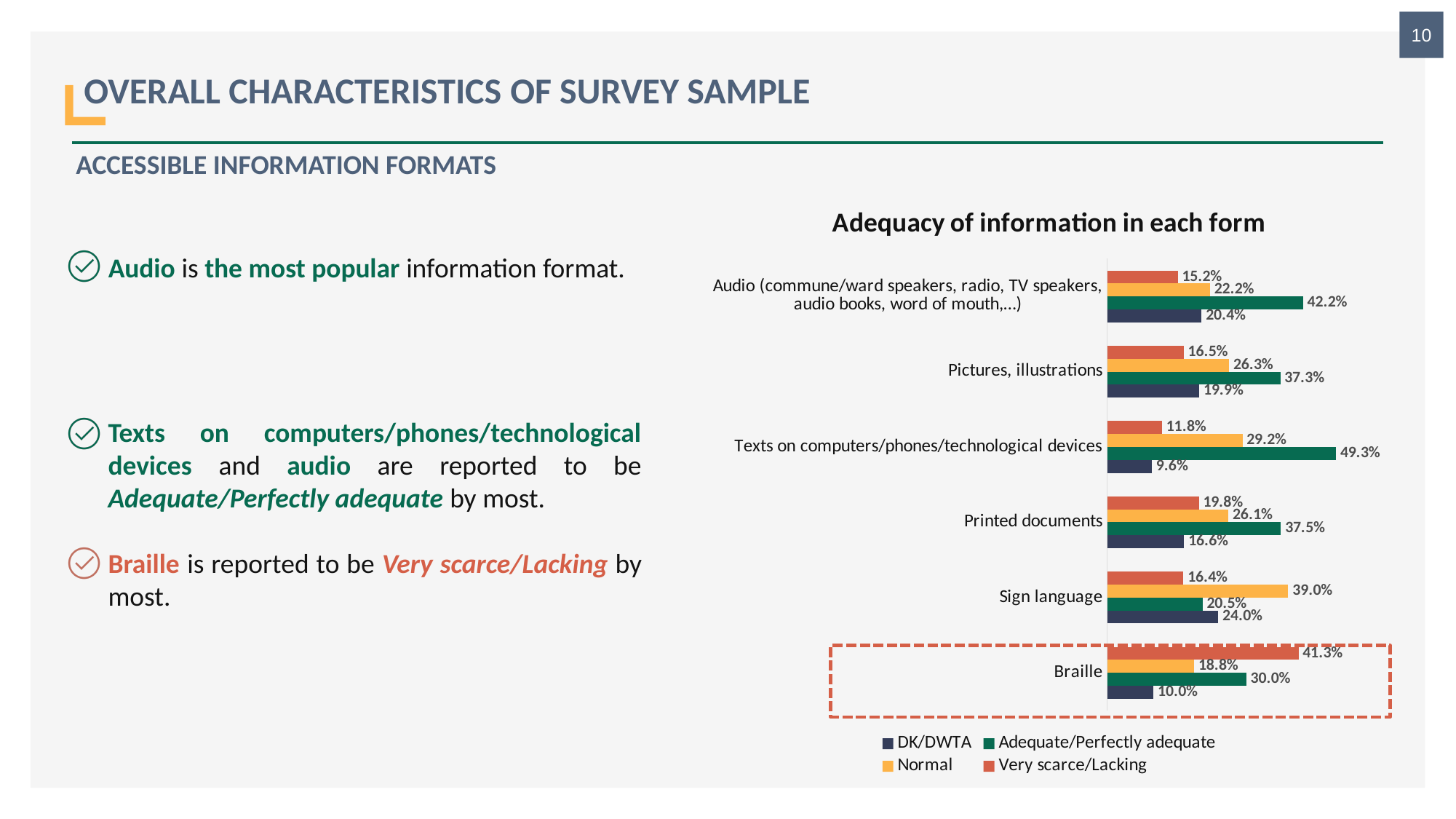
What type of chart is shown on the slide? bar chart What is the DK/DWTA value for Printed documents? 16.6% What is the Normal value for Sign language? 39.0% How many series does the chart legend list? 4 Which category has the lowest DK/DWTA value? Texts on computers/phones/technological devices What is the difference between the Adequate/Perfectly adequate value and the Very scarce/Lacking value for Audio? 27.0% For Braille, which is larger: the Very scarce/Lacking value or the Adequate/Perfectly adequate value? Very scarce/Lacking How many information formats (categories) are shown in the chart? 6 What is the Adequate/Perfectly adequate value for Texts on computers/phones/technological devices? 49.3% Which category has the highest Adequate/Perfectly adequate value? Texts on computers/phones/technological devices What is the Very scarce/Lacking value for Braille? 41.3% What is the title of the chart? Adequacy of information in each form